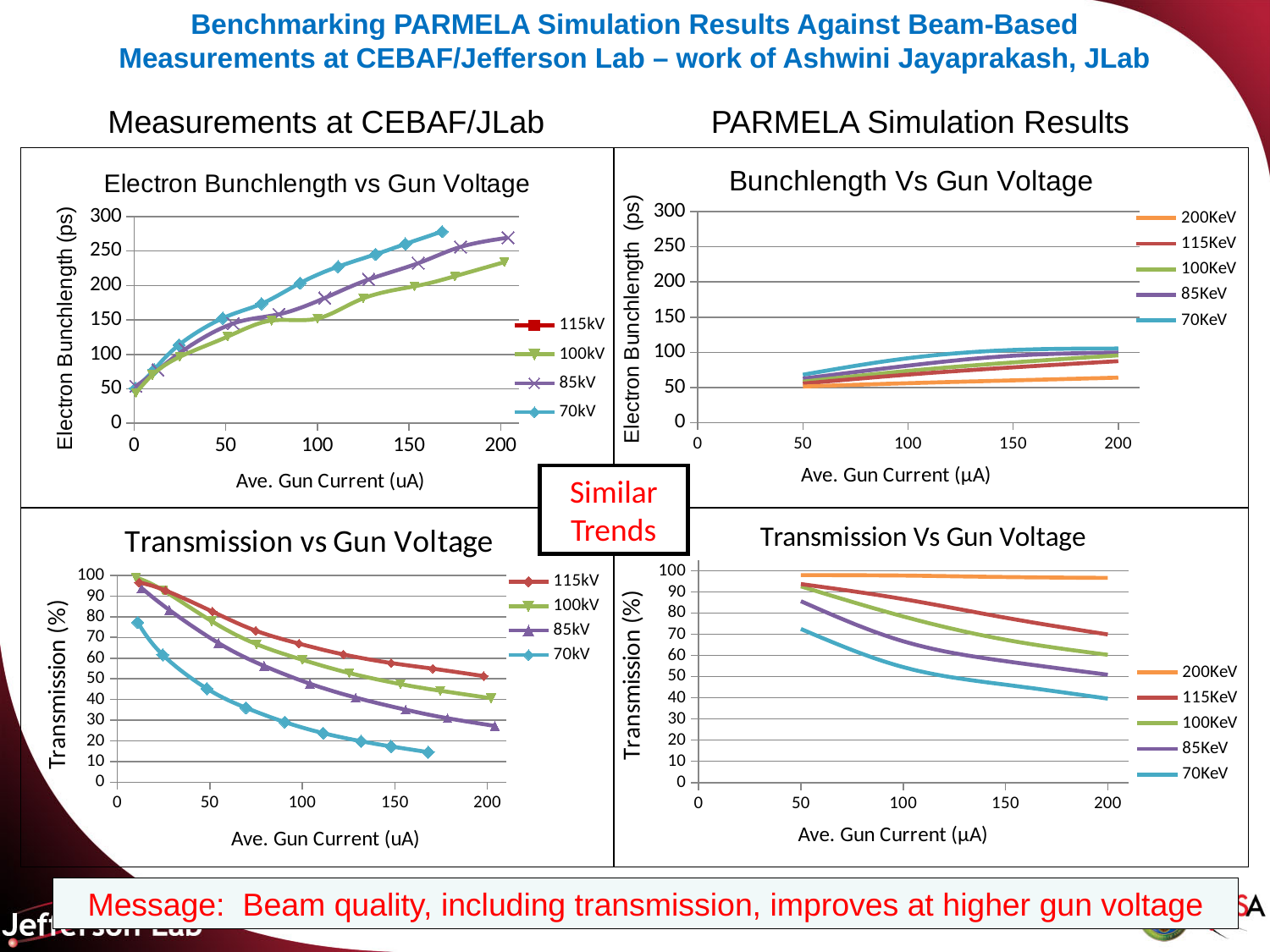
In the bottom-left chart titled "Transmission vs Gun Voltage", which series has the lowest transmission across the plotted range? 70kV In the bottom-right chart titled "Transmission Vs Gun Voltage", is the 70KeV transmission at 200 µA greater or less than 50? less In the top-left chart titled "Electron Bunchlength vs Gun Voltage", is the 70kV bunchlength at 150 uA greater or less than 200? greater In the bottom-left chart titled "Transmission vs Gun Voltage", does the 70kV series rise or fall as gun current increases? fall What is the x-axis label of the top-right chart titled "Bunchlength Vs Gun Voltage"? Ave. Gun Current (µA) In the bottom-left chart titled "Transmission vs Gun Voltage", is the 70kV transmission at 150 uA greater or less than 30? less What kind of chart is the top-left chart titled "Electron Bunchlength vs Gun Voltage"? line chart In the top-left chart titled "Electron Bunchlength vs Gun Voltage", does the 70kV series rise or fall as gun current increases? rise How many series does the legend list in the top-right chart titled "Bunchlength Vs Gun Voltage"? 5 In the bottom-right chart titled "Transmission Vs Gun Voltage", which series has the highest transmission across the plotted range? 200KeV How many series does the legend list in the top-left chart titled "Electron Bunchlength vs Gun Voltage"? 4